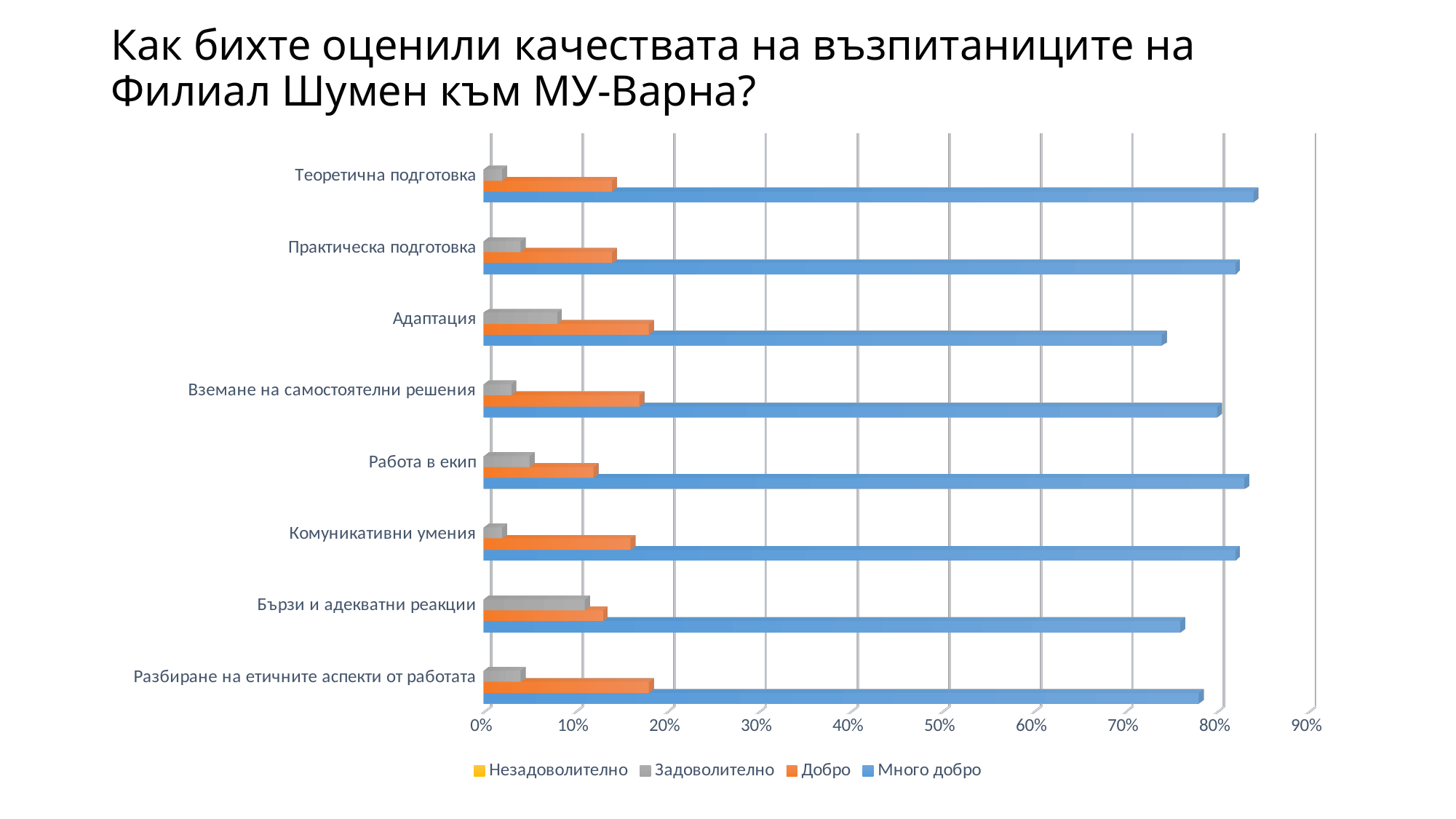
Is the 'Задоволително' value for 'Бързи и адекватни реакции' greater or less than 10%? greater What kind of chart is shown on the slide? bar chart Which is larger: the 'Добро' value for 'Адаптация' or for 'Работа в екип'? Адаптация How many categories (qualities) are listed on the vertical axis of the chart? 8 Is the 'Много добро' value for 'Адаптация' greater or less than 80%? less What is the highest value shown on the horizontal axis of the chart? 90% Is the 'Много добро' value for 'Теоретична подготовка' greater or less than 80%? greater Which category has the highest 'Задоволително' value? Бързи и адекватни реакции Which series is shown in blue in the chart legend? Много добро Which is larger: the 'Много добро' value for 'Теоретична подготовка' or for 'Адаптация'? Теоретична подготовка How many series does the chart legend list? 4